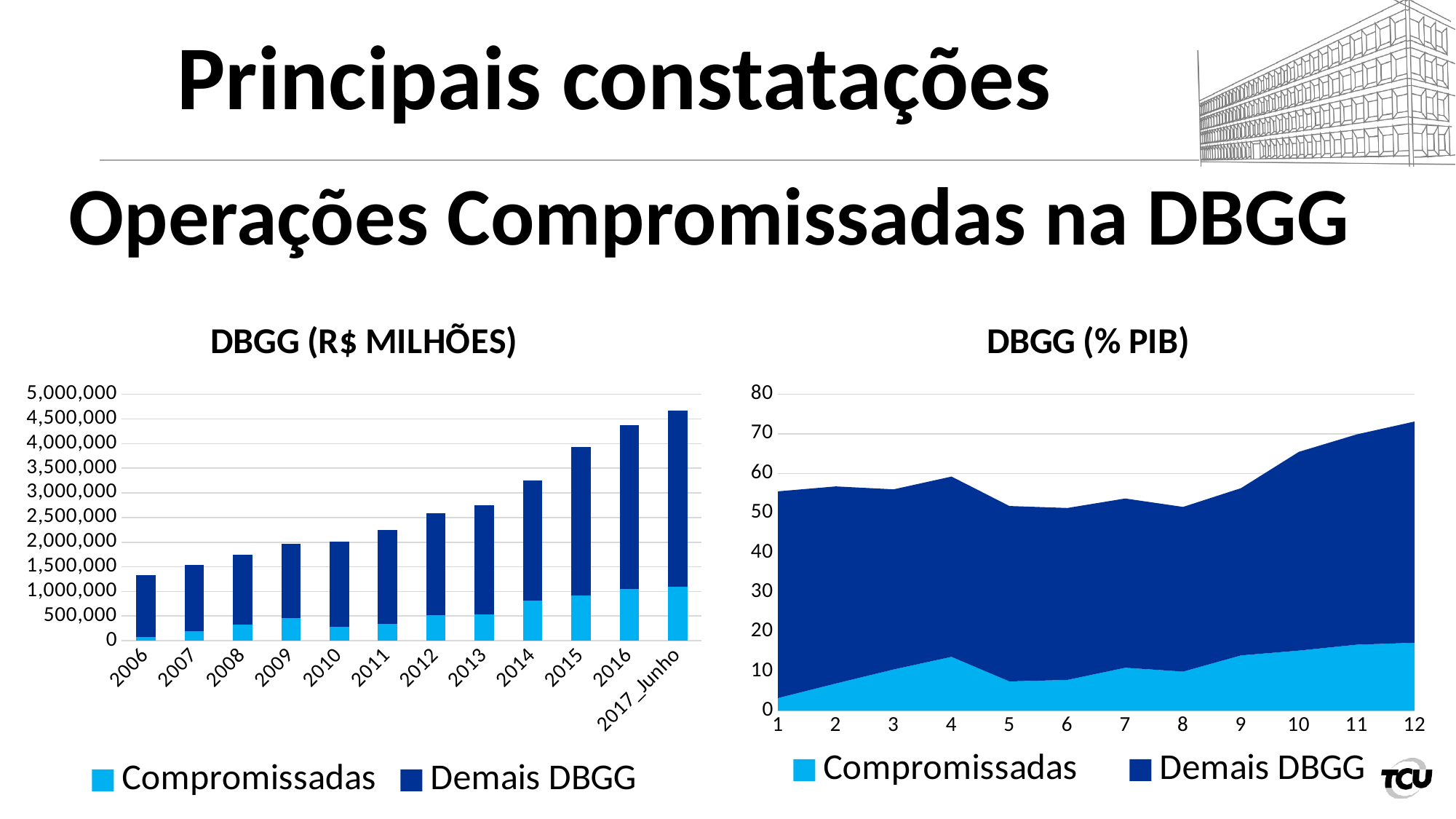
In the left chart "DBGG (R$ MILHÕES)", is the total bar for 2006 greater or less than 1,500,000? less In the right chart "DBGG (% PIB)", is the total value at point 12 greater or less than 70? greater What type of chart is the left chart titled "DBGG (R$ MILHÕES)"? stacked bar chart In the left chart "DBGG (R$ MILHÕES)", is the total bar for 2017_Junho greater or less than 4,500,000? greater What type of chart is the right chart titled "DBGG (% PIB)"? stacked area chart In the left chart "DBGG (R$ MILHÕES)", how many series does the legend list? 2 In the left chart "DBGG (R$ MILHÕES)", how many bars (categories) are shown on the x axis? 12 In the right chart "DBGG (% PIB)", which series is shown in light blue according to the legend? Compromissadas In the left chart "DBGG (R$ MILHÕES)", which category has the shortest total bar? 2006 In the left chart "DBGG (R$ MILHÕES)", do the total bars generally rise or fall from 2006 to 2017_Junho? rise In the left chart "DBGG (R$ MILHÕES)", which category has the tallest total bar? 2017_Junho